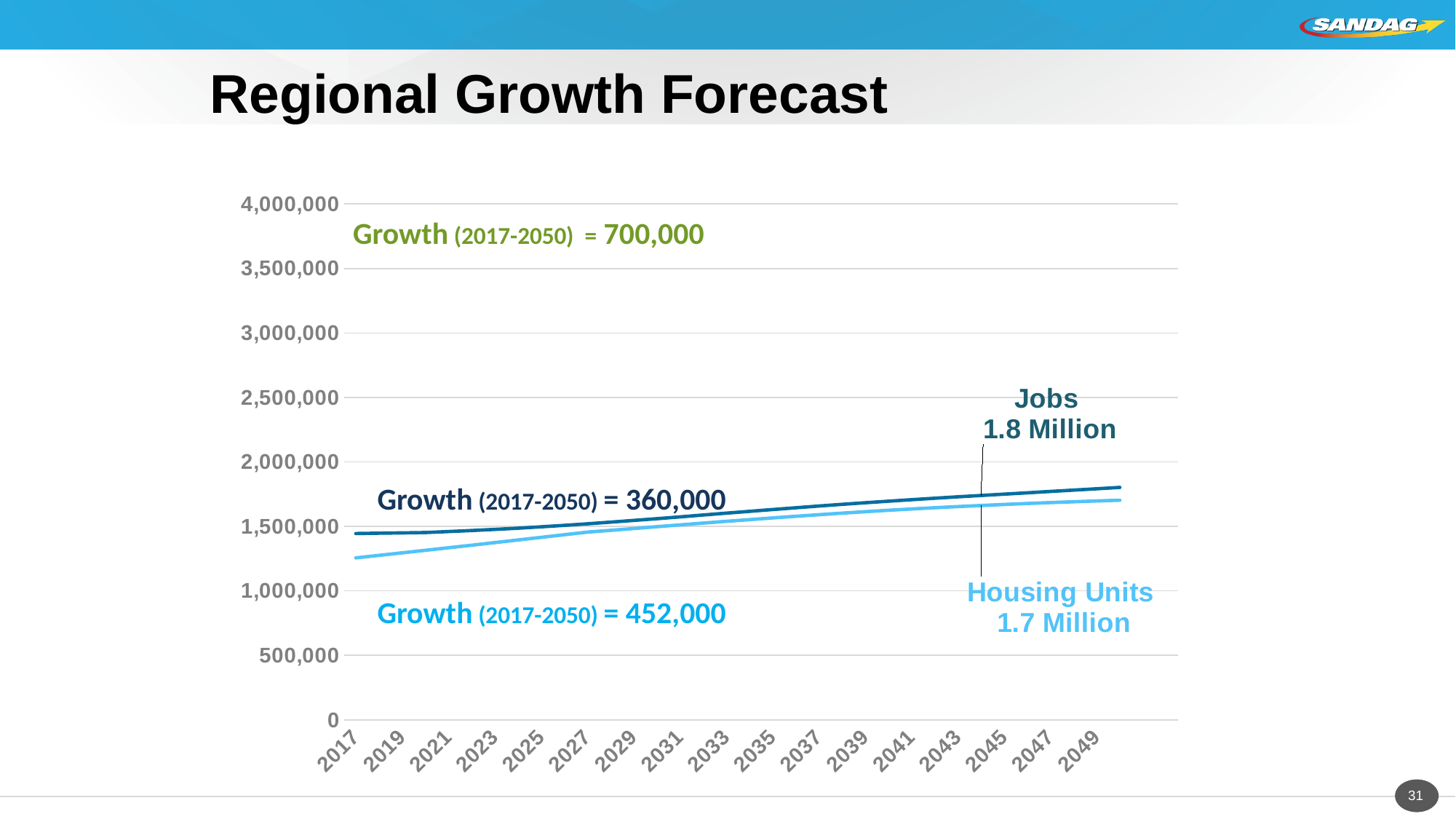
What kind of chart is shown on the slide? line chart What value is labelled for Jobs at the end of the forecast? 1.8 Million What is the title of the slide's chart? Regional Growth Forecast Is the value for Housing Units in 2017 greater or less than 1,500,000? less What is the difference between the Housing Units growth (2017-2050) and the Jobs growth (2017-2050)? 92,000 What value is labelled for Housing Units at the end of the forecast? 1.7 Million How many year labels are shown on the x axis? 17 Which has the larger growth (2017-2050), Jobs or Housing Units? Housing Units Is the value for Jobs in 2049 greater or less than 2,000,000? less What growth (2017-2050) value is shown for Housing Units? 452,000 Do the Jobs values rise or fall from 2017 to 2049? rise What growth (2017-2050) value is shown for Jobs? 360,000